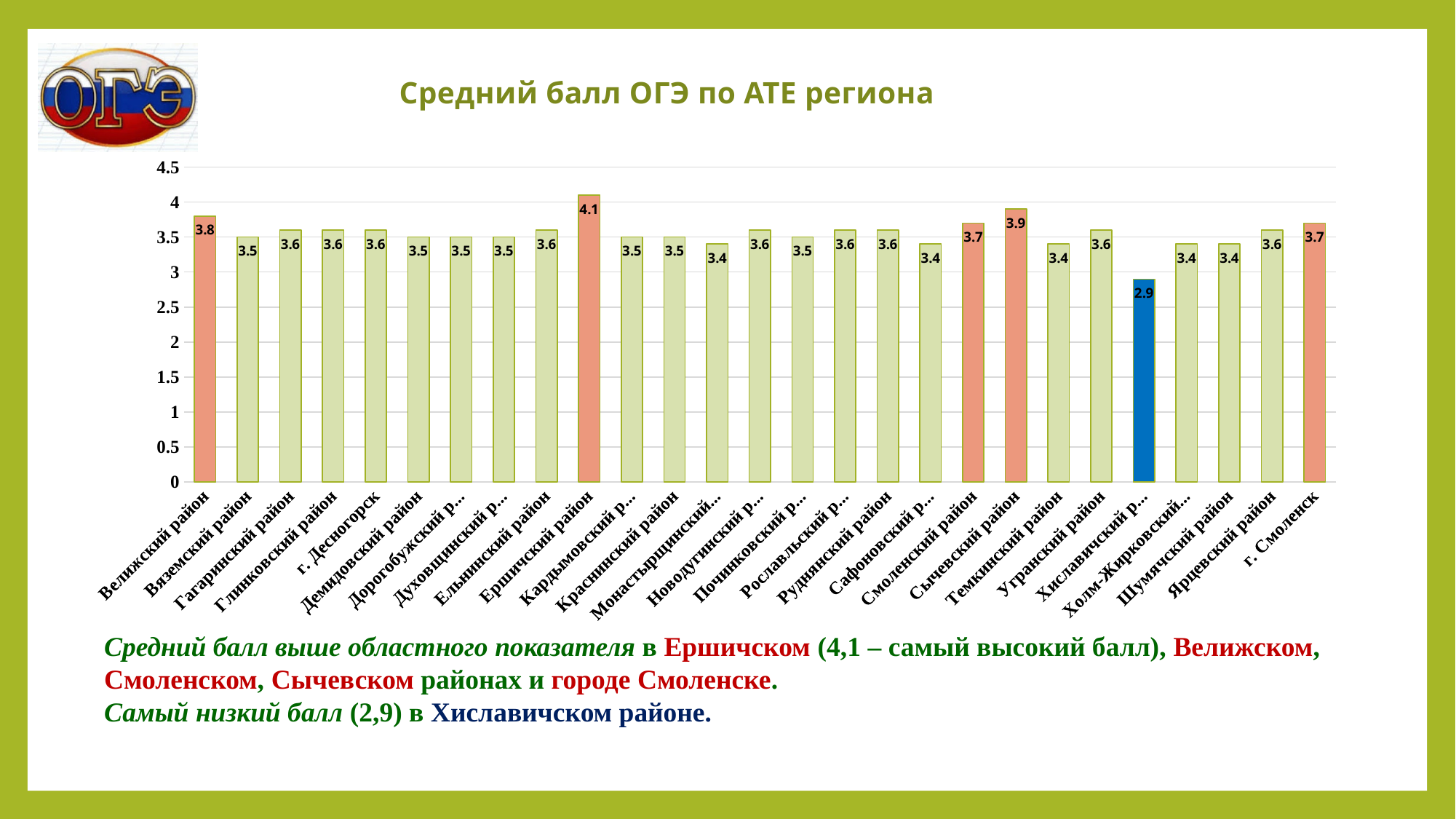
What type of chart is shown on the slide? Bar chart What is the value shown for г. Смоленск? 3.7 How many districts (bars) are shown in the chart? 27 Which has a higher score, Велижский район or Смоленский район? Велижский район What is the average OGE score for Хиславичский район? 2.9 What is the difference between the scores of Сычевский район and Велижский район? 0.1 Which district has the highest average score? Ершичский район What is the title of the chart? Средний балл ОГЭ по АТЕ региона What is the average OGE score for Ершичский район? 4.1 What is the value shown for Сычевский район? 3.9 What is the difference between the scores of Ершичский район and Хиславичский район? 1.2 Which district has the lowest average score? Хиславичский район